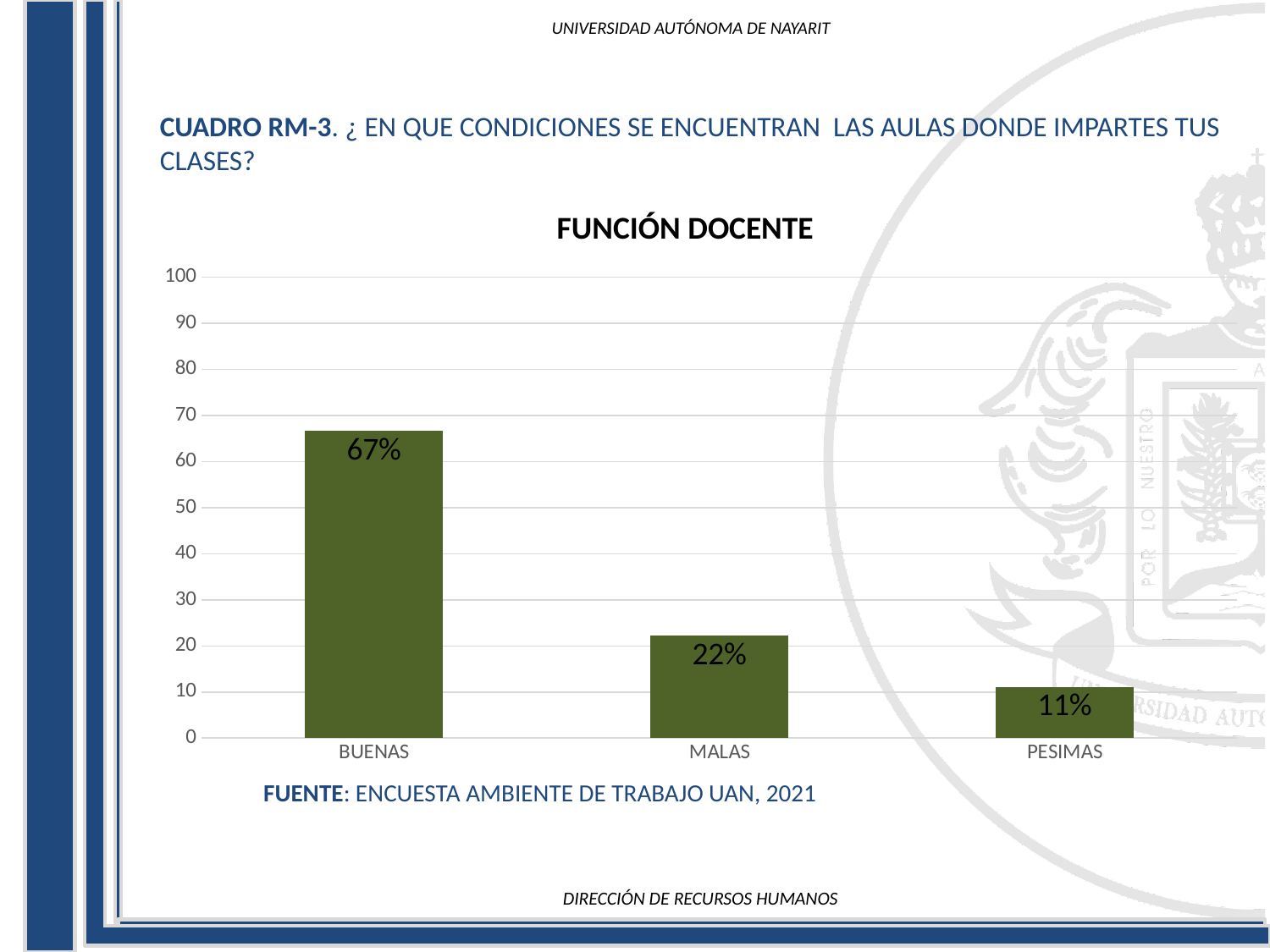
What is the value for MALAS? 22% What kind of chart is shown on the slide? bar chart What is the value for BUENAS? 67% How many categories are shown on the x axis? 3 What is the title of the chart? FUNCIÓN DOCENTE What is the difference between the values for BUENAS and MALAS? 45% Which category has the lowest value? PESIMAS Is the value for BUENAS greater or less than 50? greater Which category has the highest value? BUENAS What is the value for PESIMAS? 11% What is the difference between the values for MALAS and PESIMAS? 11% Which is larger, the value for MALAS or the value for PESIMAS? MALAS